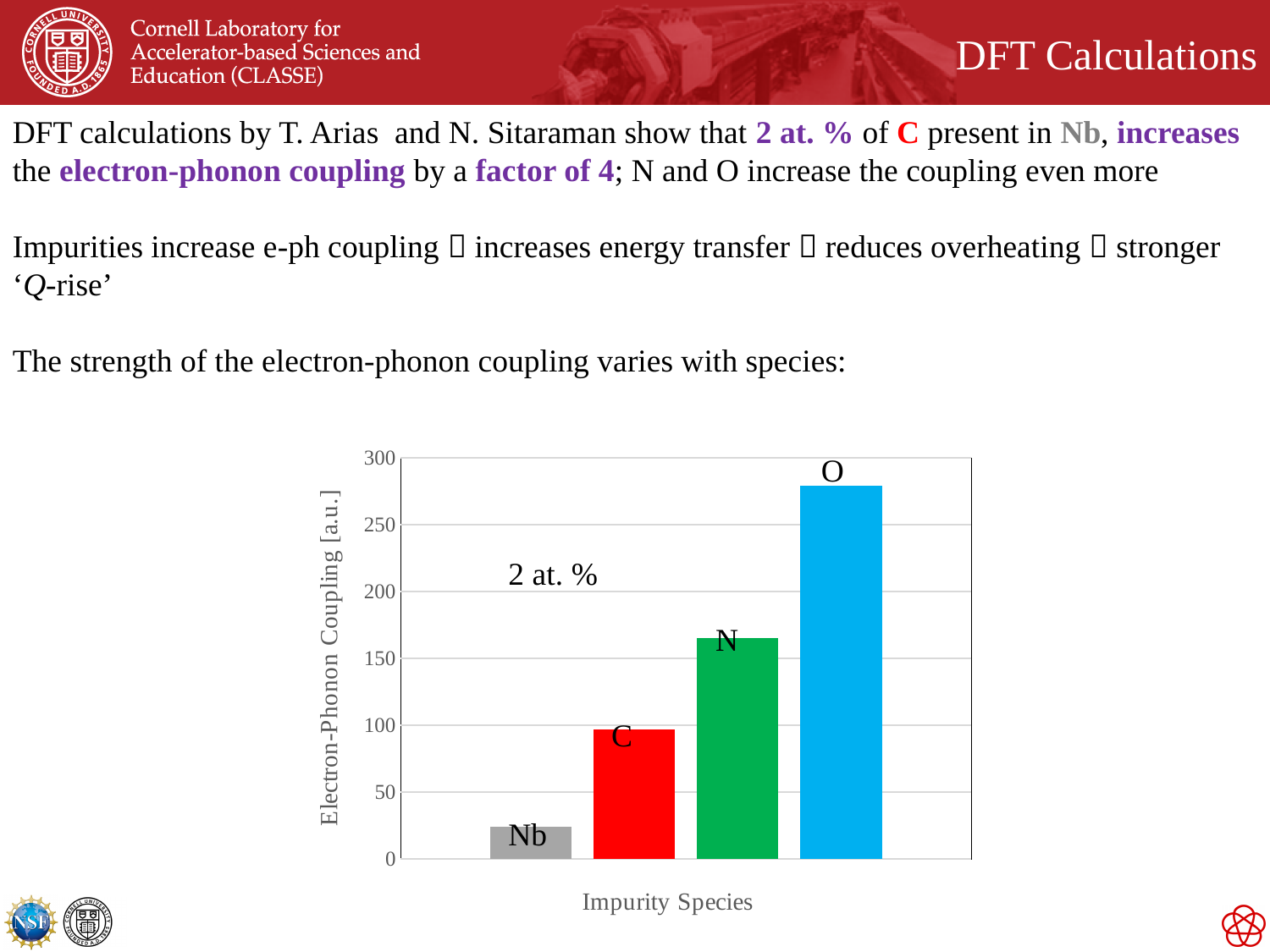
Is the electron-phonon coupling value for N greater or less than 150? greater What kind of chart is shown on the slide? bar chart Is the electron-phonon coupling value for Nb greater or less than 50? less Do the bar values rise or fall moving from Nb to O along the x axis? rise Which impurity species has the highest electron-phonon coupling in the chart? O Which has a larger electron-phonon coupling, N or C? N Is the electron-phonon coupling value for O greater or less than 250? greater How many impurity species (bars) are plotted in the chart? 4 Which has a larger electron-phonon coupling, O or N? O What is the label of the y axis of the chart? Electron-Phonon Coupling [a.u.] What colour is the bar for C in the chart? red Which species has the lowest electron-phonon coupling in the chart? Nb